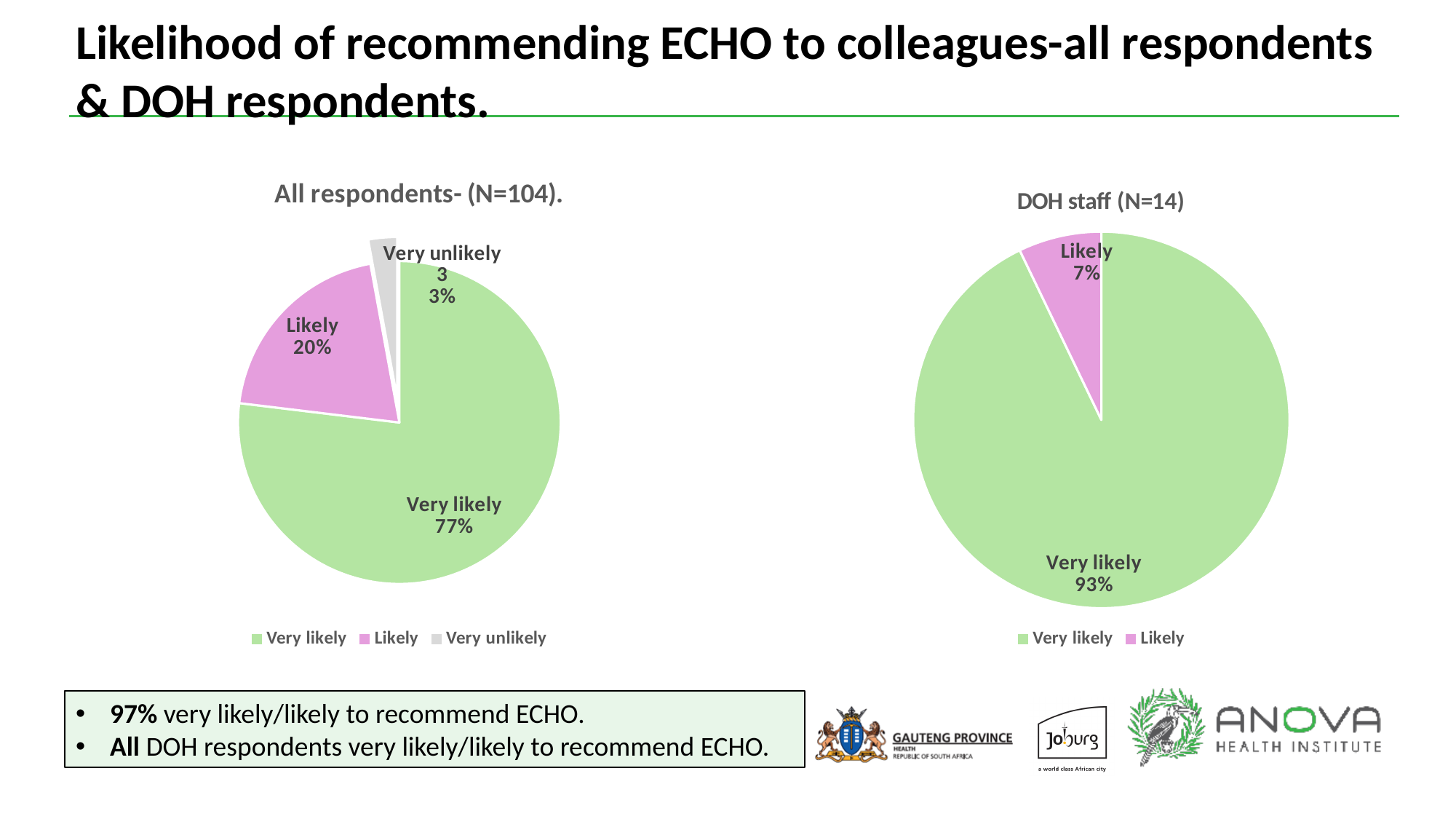
What type of chart is the 'DOH staff (N=14)' chart? Pie chart In the 'All respondents- (N=104)' chart, what percentage of respondents are 'Very likely' to recommend ECHO? 77% In the 'All respondents- (N=104)' chart, what percentage of respondents are 'Very unlikely' to recommend ECHO? 3% In the 'All respondents- (N=104)' chart, what percentage of respondents are 'Likely' to recommend ECHO? 20% In the 'DOH staff (N=14)' chart, what percentage of respondents are 'Very likely' to recommend ECHO? 93% In the 'DOH staff (N=14)' chart, what is the difference in percentage points between 'Very likely' and 'Likely'? 86 percentage points How many categories does the legend of the 'All respondents- (N=104)' chart list? 3 In the 'All respondents- (N=104)' chart, which category has the smallest share? Very unlikely In the 'All respondents- (N=104)' chart, what is the difference in percentage points between 'Very likely' and 'Likely'? 57 percentage points How many categories does the legend of the 'DOH staff (N=14)' chart list? 2 In the 'DOH staff (N=14)' chart, what percentage of respondents are 'Likely' to recommend ECHO? 7% In the 'All respondents- (N=104)' chart, which category has the largest share? Very likely